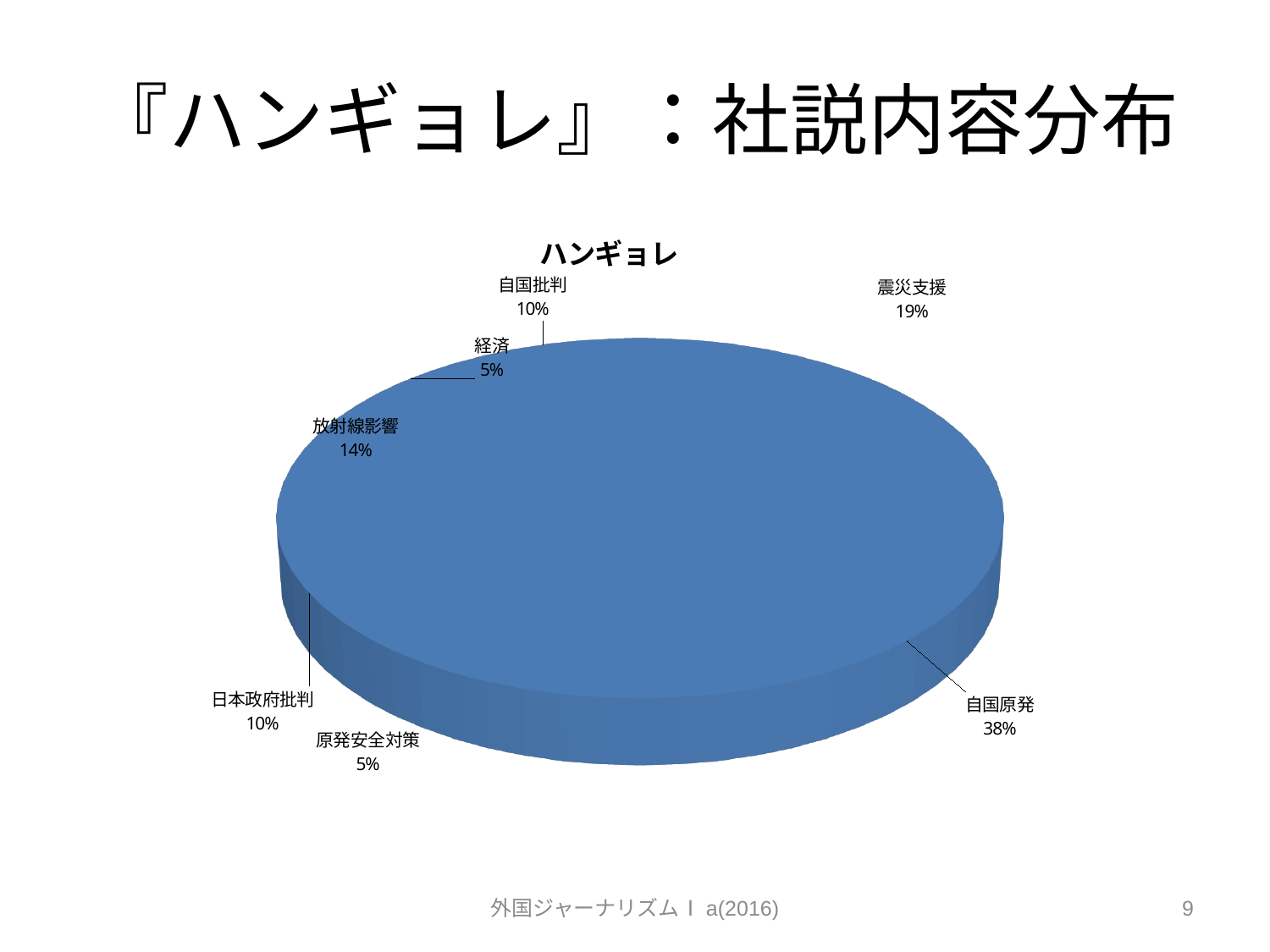
What is the value shown for 震災支援? 19% What kind of chart is shown on the slide? Pie chart How many categories are shown in the pie chart? 7 What is the value shown for 日本政府批判? 10% Which is larger, the share for 震災支援 or the share for 放射線影響? 震災支援 Which category has the largest share of the pie? 自国原発 What is the difference in percentage points between 自国原発 and 震災支援? 19 What is the value shown for 放射線影響? 14% What share of the pie does 自国原発 account for? 38% What is the value shown for 経済? 5% What is the difference in percentage points between 放射線影響 and 自国批判? 4 What is the chart's title? ハンギョレ